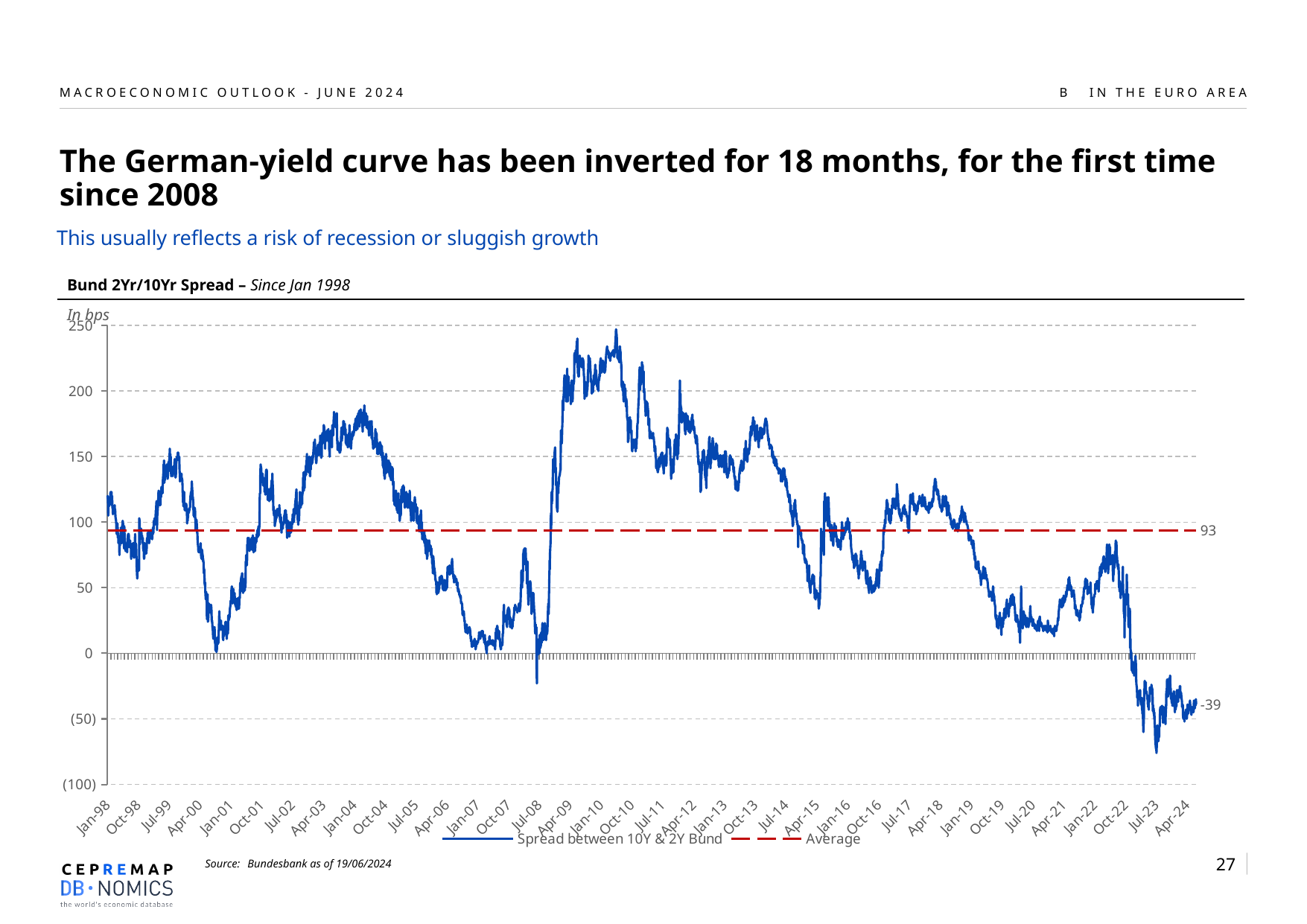
Which is higher: the spread around Jan-10 or the spread around Jan-04? Jan-10 Is the spread around Jan-01 greater or less than 50? less Does the spread rise or fall between Jan-22 and Jul-23? fall What unit is the spread measured in, according to the axis label? bps How many series does the legend list? 2 What is the latest value of the spread between 10Y & 2Y Bund labelled at the right end of the line? -39 Which is larger: the latest spread value or the average? the average Is the spread around Jan-10 greater or less than 200? greater What is the value of the Average line shown on the chart? 93 What kind of chart is shown on the slide? line chart Is the spread around Jul-23 greater or less than 0? less By how many bps is the latest spread value (-39) below the average (93)? 132